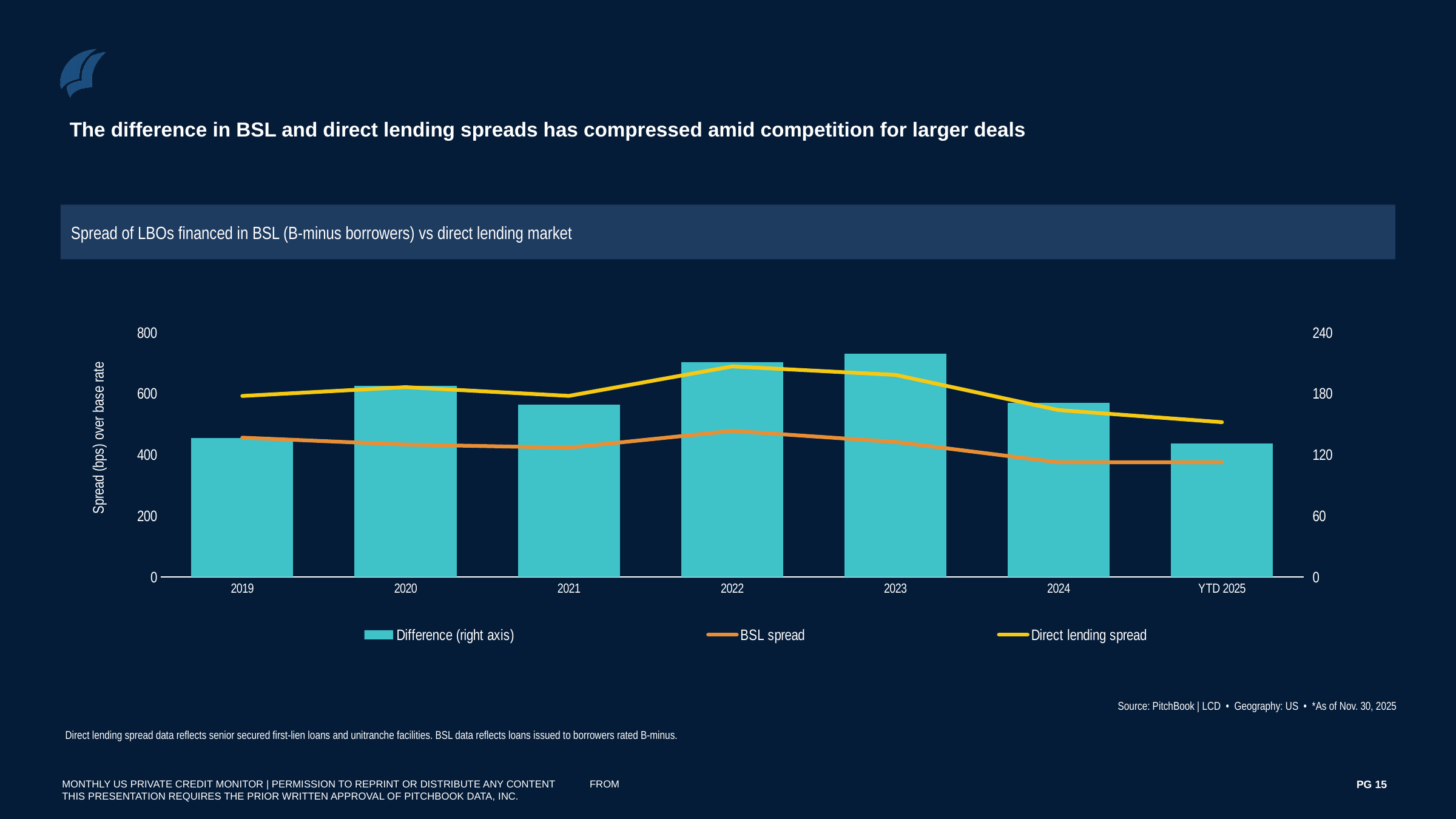
In which year is the Direct lending spread at its lowest? YTD 2025 How many categories are shown on the x axis? 7 In which year is the Difference bar the highest? 2023 Is the Difference value for 2023 on the right axis greater or less than 180? greater Does the Direct lending spread rise or fall from 2023 to YTD 2025? Fall Is the BSL spread in 2024 greater or less than 400? less Which is larger in 2023, the Direct lending spread or the BSL spread? Direct lending spread Is the Direct lending spread in 2022 greater or less than 600? greater In which year does the Direct lending spread line reach its highest point? 2022 What is the label on the left vertical axis? Spread (bps) over base rate How many series does the legend list? 3 What kind of chart is shown on the slide? A combination bar and line chart